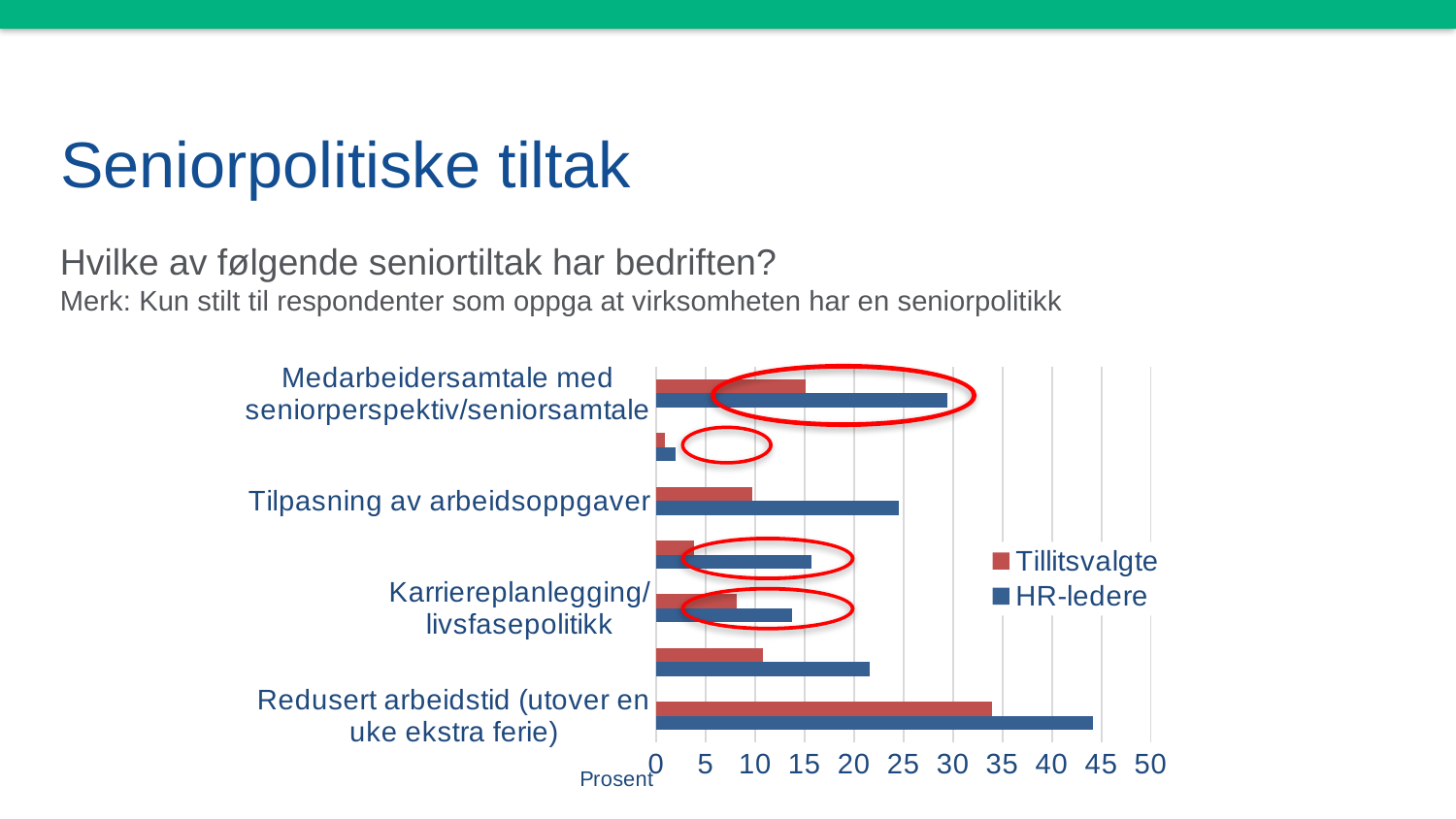
Is the HR-ledere value for Karriereplanlegging/livsfasepolitikk greater or less than 20? less What is the label on the horizontal axis? Prosent What kind of chart is shown on the slide? Bar chart How many series does the legend list? 2 Which category has the highest value for Tillitsvalgte? Redusert arbeidstid (utover en uke ekstra ferie) Is the HR-ledere value for Medarbeidersamtale med seniorperspektiv/seniorsamtale greater or less than 25? greater Which is larger: the Tillitsvalgte value for Redusert arbeidstid (utover en uke ekstra ferie) or the HR-ledere value for Medarbeidersamtale med seniorperspektiv/seniorsamtale? Tillitsvalgte value for Redusert arbeidstid (utover en uke ekstra ferie) Is the Tillitsvalgte value for Tilpasning av arbeidsoppgaver greater or less than 15? less For Tilpasning av arbeidsoppgaver, which series has the larger value, Tillitsvalgte or HR-ledere? HR-ledere Which category has the highest value for HR-ledere? Redusert arbeidstid (utover en uke ekstra ferie) What are the two series named in the legend? Tillitsvalgte and HR-ledere